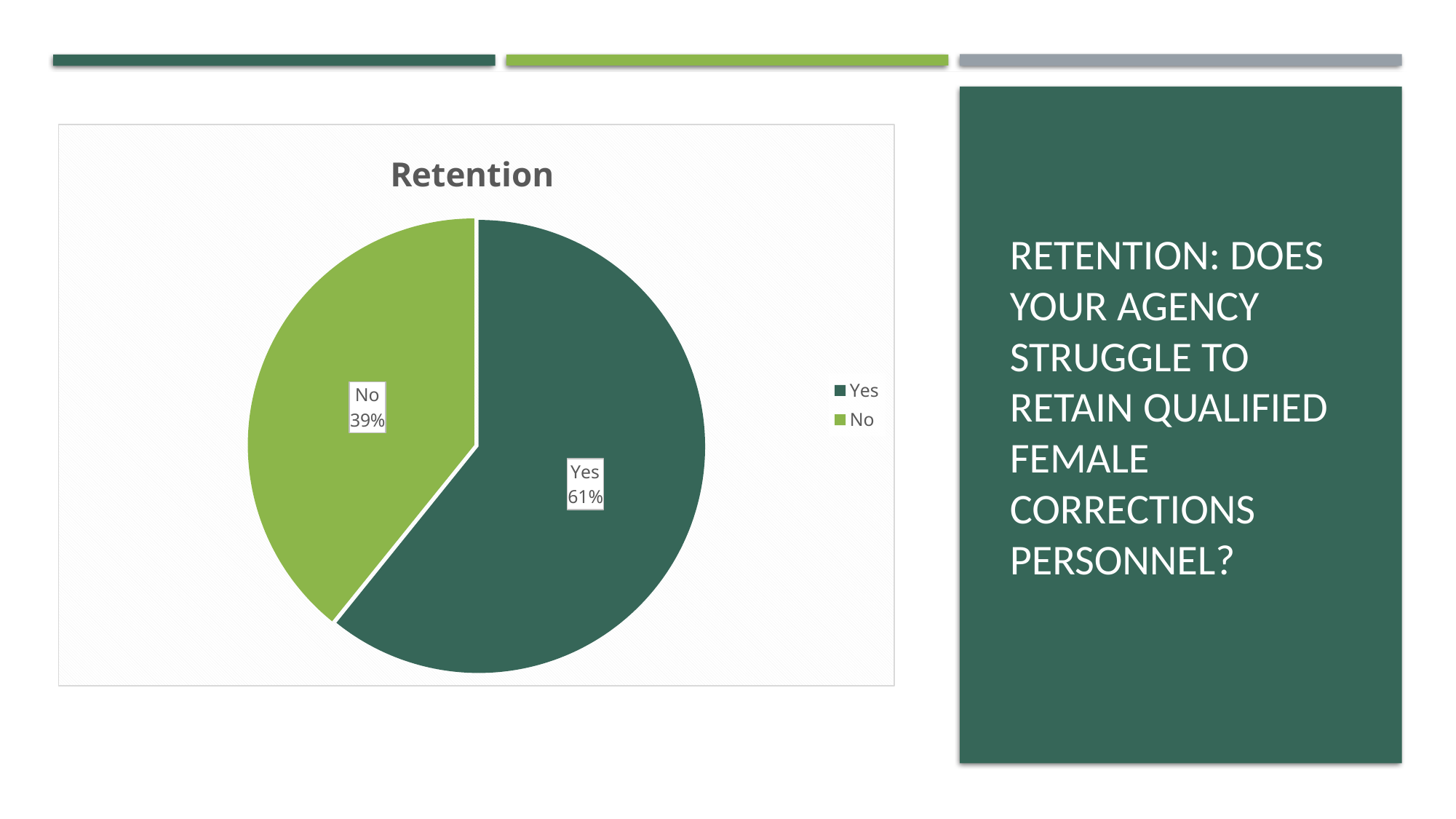
What percentage of the pie is the Yes slice? 61% Which slice is the largest in the pie chart? Yes What type of chart is shown on the slide? pie chart Which colour is used for the Yes slice? dark green How many entries does the legend list? 2 How many slices does the pie chart have? 2 Which is larger, the Yes slice or the No slice? Yes What share of the pie does the No slice represent? 39% What is the title of the chart? Retention Which slice is the smallest in the pie chart? No What percentage of the pie is the No slice? 39% What is the difference in percentage points between the Yes and No slices? 22